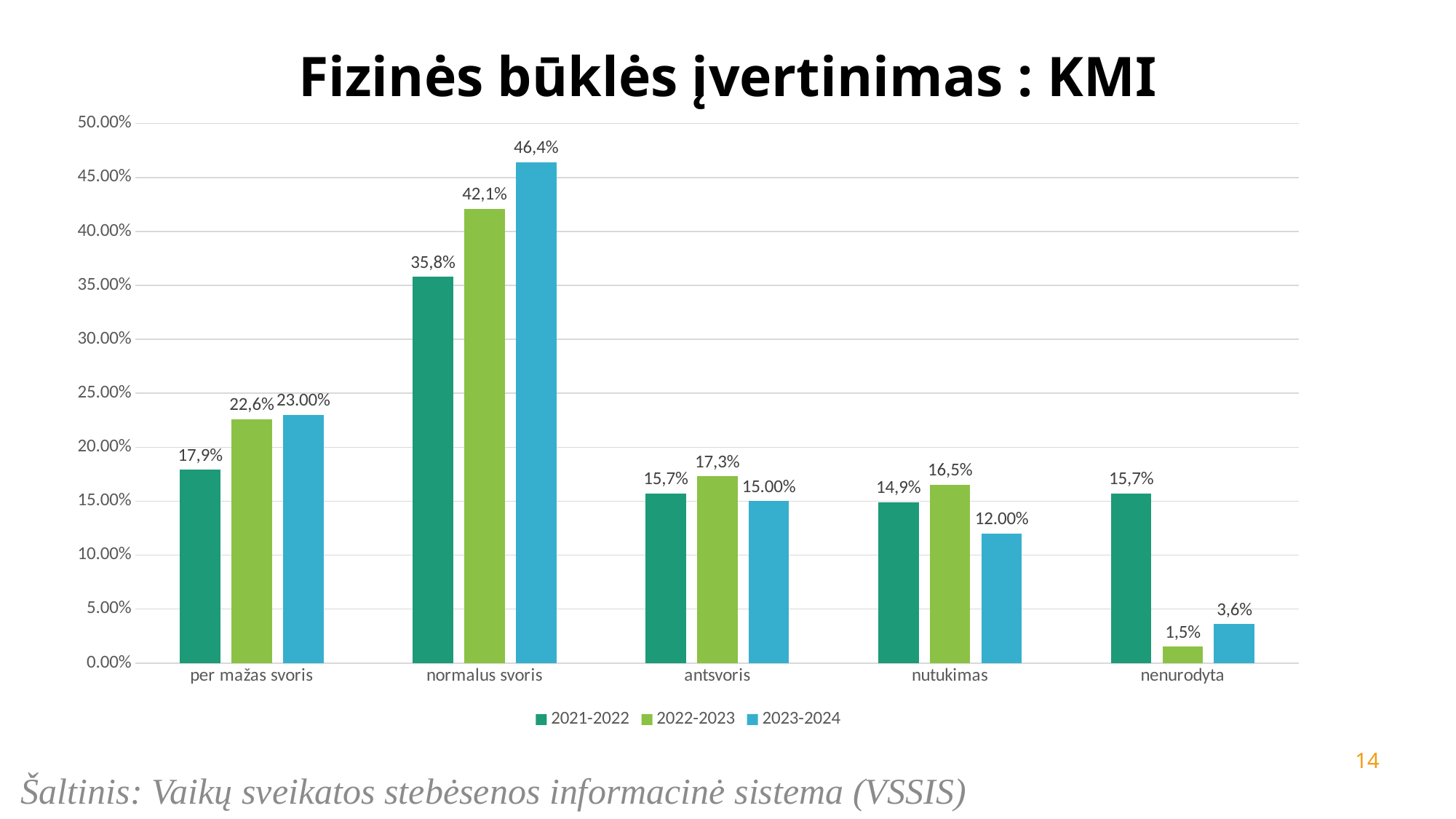
What is the value for normalus svoris in the 2023-2024 series? 46,4% What is the value for per mažas svoris in the 2021-2022 series? 17,9% What is the title of the chart? Fizinės būklės įvertinimas : KMI What is the value for nenurodyta in the 2022-2023 series? 1,5% What is the value for nutukimas in the 2023-2024 series? 12.00% What is the difference between the 2023-2024 and 2021-2022 values for normalus svoris? 10,6% Which category has the highest value in the 2022-2023 series? normalus svoris How many series does the legend list? 3 How many categories are shown on the x axis? 5 Which category has the lowest value in the 2023-2024 series? nenurodyta What kind of chart is shown on the slide? bar chart Which is larger for antsvoris: the 2022-2023 value or the 2023-2024 value? 2022-2023